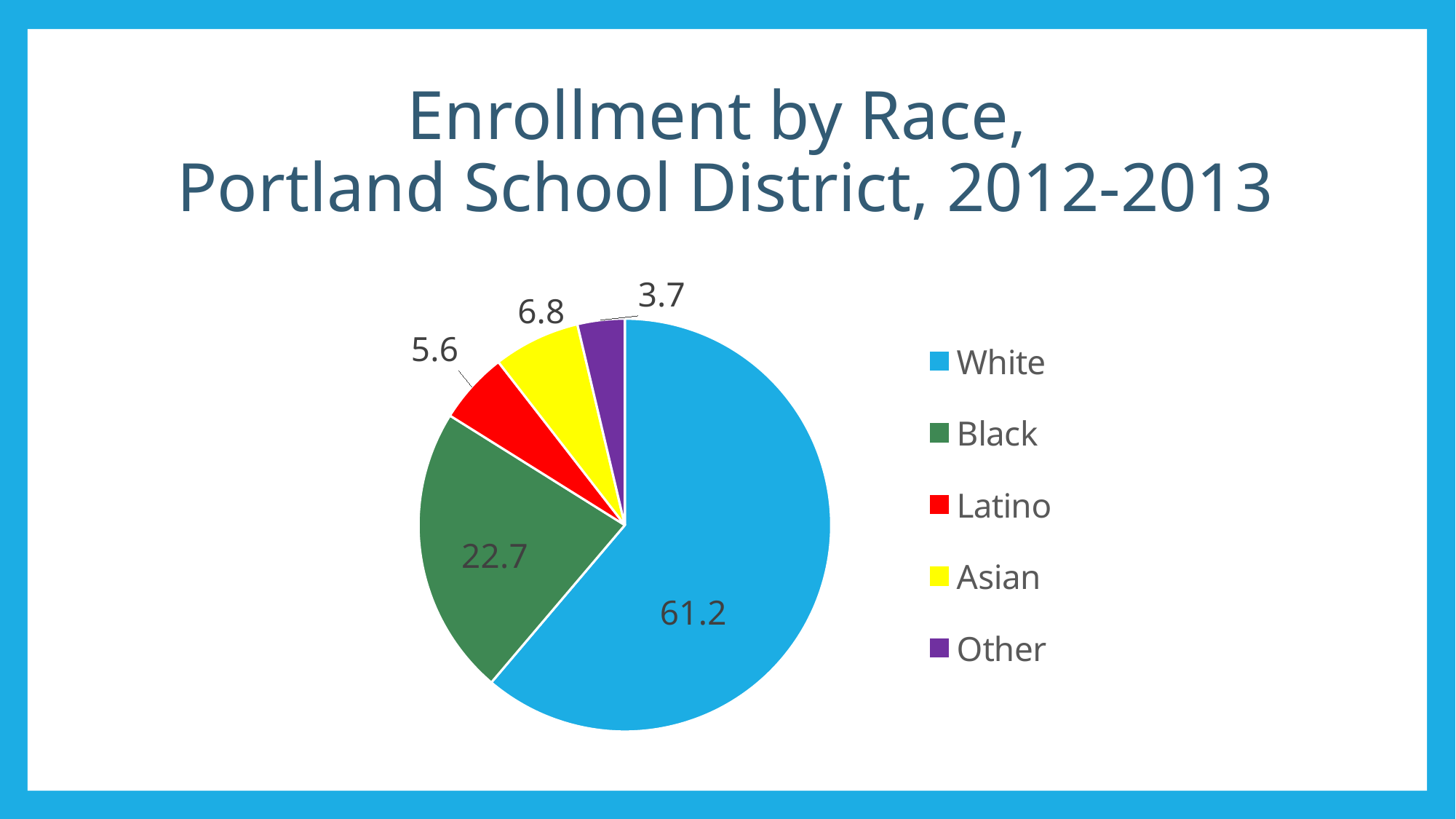
Which category has the largest slice? White What is the value for Latino? 5.6 How many categories does the legend list? 5 What kind of chart is shown on the slide? pie chart What is the value for Black? 22.7 Which is larger, the value for Asian or the value for Latino? Asian What is the title of the chart? Enrollment by Race, Portland School District, 2012-2013 Which category has the smallest slice? Other What is the difference between the values for White and Black? 38.5 What is the value for Asian? 6.8 What is the value for Other? 3.7 What is the value for White? 61.2